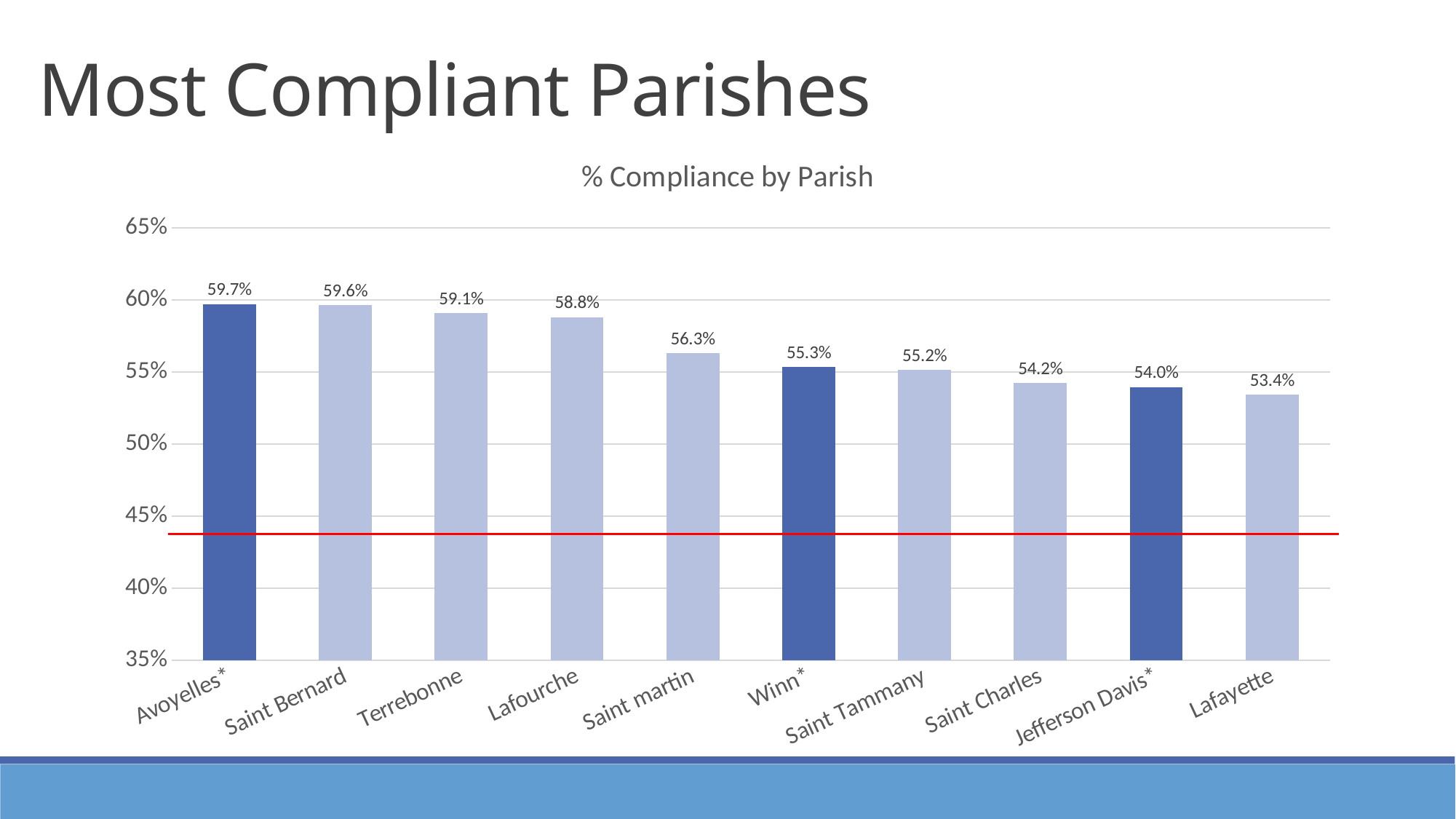
What is the difference in % compliance between Avoyelles* and Lafayette? 6.3% Is the value for Jefferson Davis* greater or less than 55%? less What kind of chart is shown on the slide? Bar chart What is the % compliance for Lafayette? 53.4% What is the % compliance for Terrebonne? 59.1% Which parish has the lowest % compliance? Lafayette What is the title of the chart? % Compliance by Parish What is the difference in % compliance between Lafourche and Saint martin? 2.5% How many parishes are shown in the chart? 10 Which has a higher % compliance, Saint martin or Saint Charles? Saint martin What is the % compliance for Saint Tammany? 55.2% Which parish has the highest % compliance? Avoyelles*